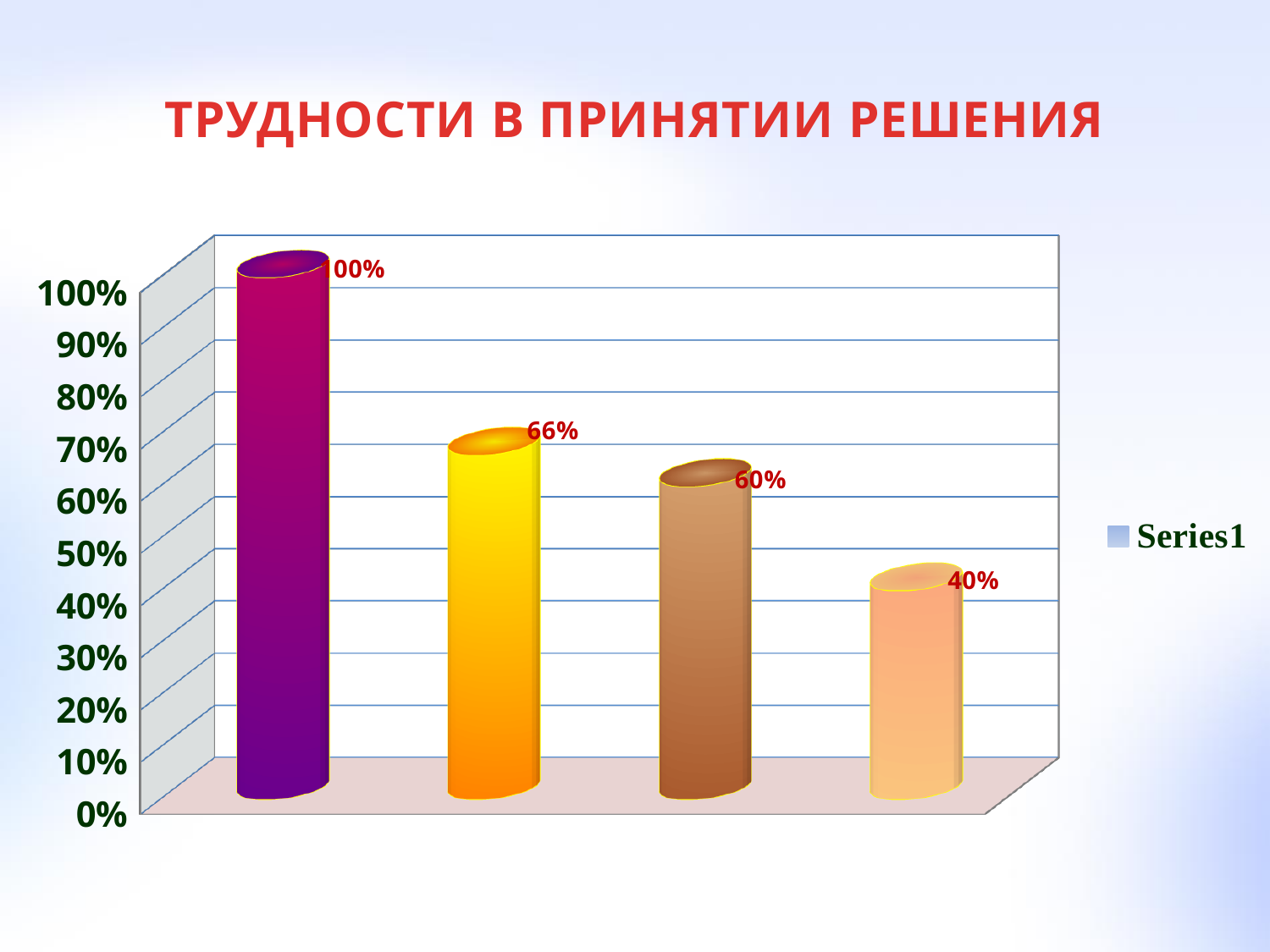
What type of chart is shown on the slide? bar chart How many bars are plotted in the chart? 4 What is the difference between the first bar (100%) and the second bar (66%)? 34% What is the value shown on the third (brown) bar? 60% Which bar has the lowest value? the fourth (rightmost) bar, 40% How many series does the legend list? 1 Do the bar values rise or fall from left to right? fall What is the value shown on the first (leftmost, purple) bar? 100% What is the value shown on the second (yellow) bar? 66% What is the value shown on the fourth (rightmost, light orange) bar? 40% Which is larger, the value of the second bar or the value of the third bar? the second bar (66%) What is the title of the chart? ТРУДНОСТИ В ПРИНЯТИИ РЕШЕНИЯ